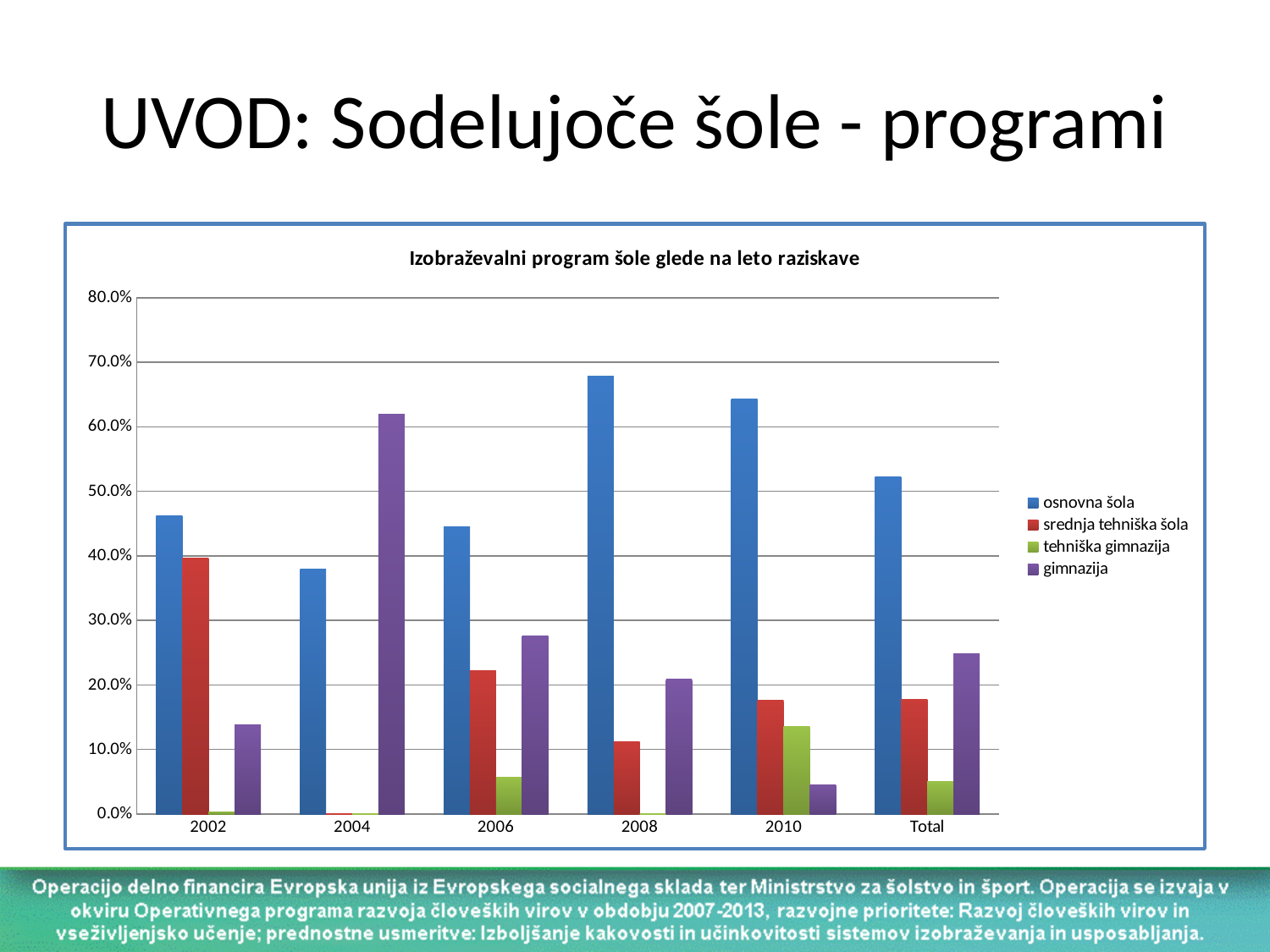
What kind of chart is shown on the slide? bar chart How many categories are shown on the x axis? 6 In which category is the value for gimnazija highest? 2004 Is the value for srednja tehniška šola in 2006 greater or less than 30.0%? less In 2010, which is larger: tehniška gimnazija or gimnazija? tehniška gimnazija Is the value for osnovna šola in 2008 greater or less than 60.0%? greater How many series does the legend list? 4 What is the title of the chart? Izobraževalni program šole glede na leto raziskave In 2002, which is larger: osnovna šola or srednja tehniška šola? osnovna šola In which category is the value for osnovna šola lowest? 2004 Is the value for gimnazija in 2004 greater or less than 50.0%? greater In which category is the value for osnovna šola highest? 2008